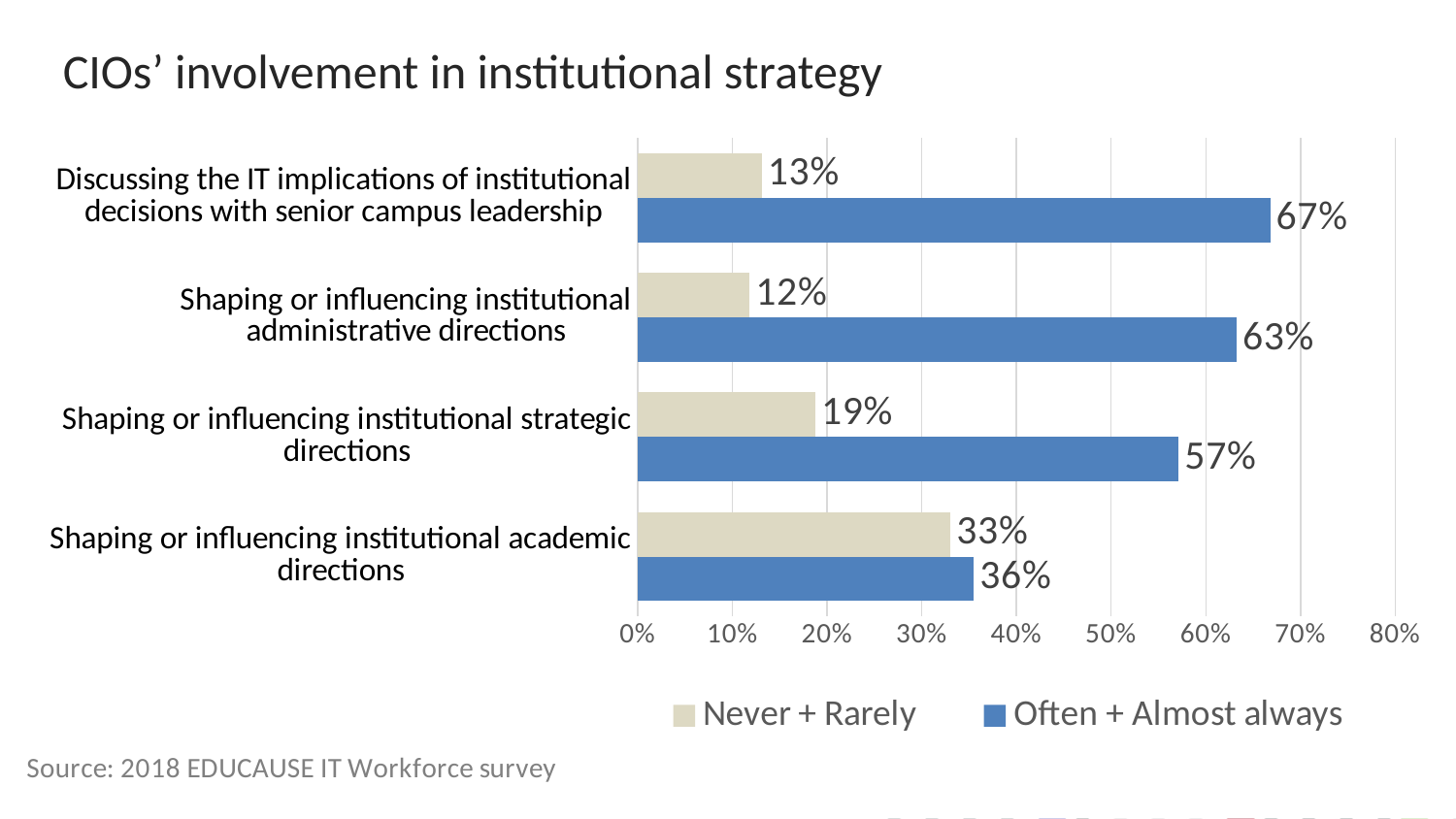
Which category has the lowest 'Often + Almost always' value? Shaping or influencing institutional academic directions What is the difference between the 'Often + Almost always' and 'Never + Rarely' values for shaping or influencing institutional administrative directions? 51 percentage points What is the 'Never + Rarely' value for shaping or influencing institutional academic directions? 33% Which category has the lowest 'Never + Rarely' value? Shaping or influencing institutional administrative directions For shaping or influencing institutional academic directions, which is larger: 'Never + Rarely' or 'Often + Almost always'? Often + Almost always Which category has the highest 'Often + Almost always' value? Discussing the IT implications of institutional decisions with senior campus leadership What is the title of the chart? CIOs' involvement in institutional strategy How many series does the legend list? 2 What kind of chart is shown on the slide? Bar chart What percentage of CIOs report 'Often + Almost always' for discussing the IT implications of institutional decisions with senior campus leadership? 67% How many categories are shown on the chart? 4 What is the 'Never + Rarely' value for shaping or influencing institutional strategic directions? 19%